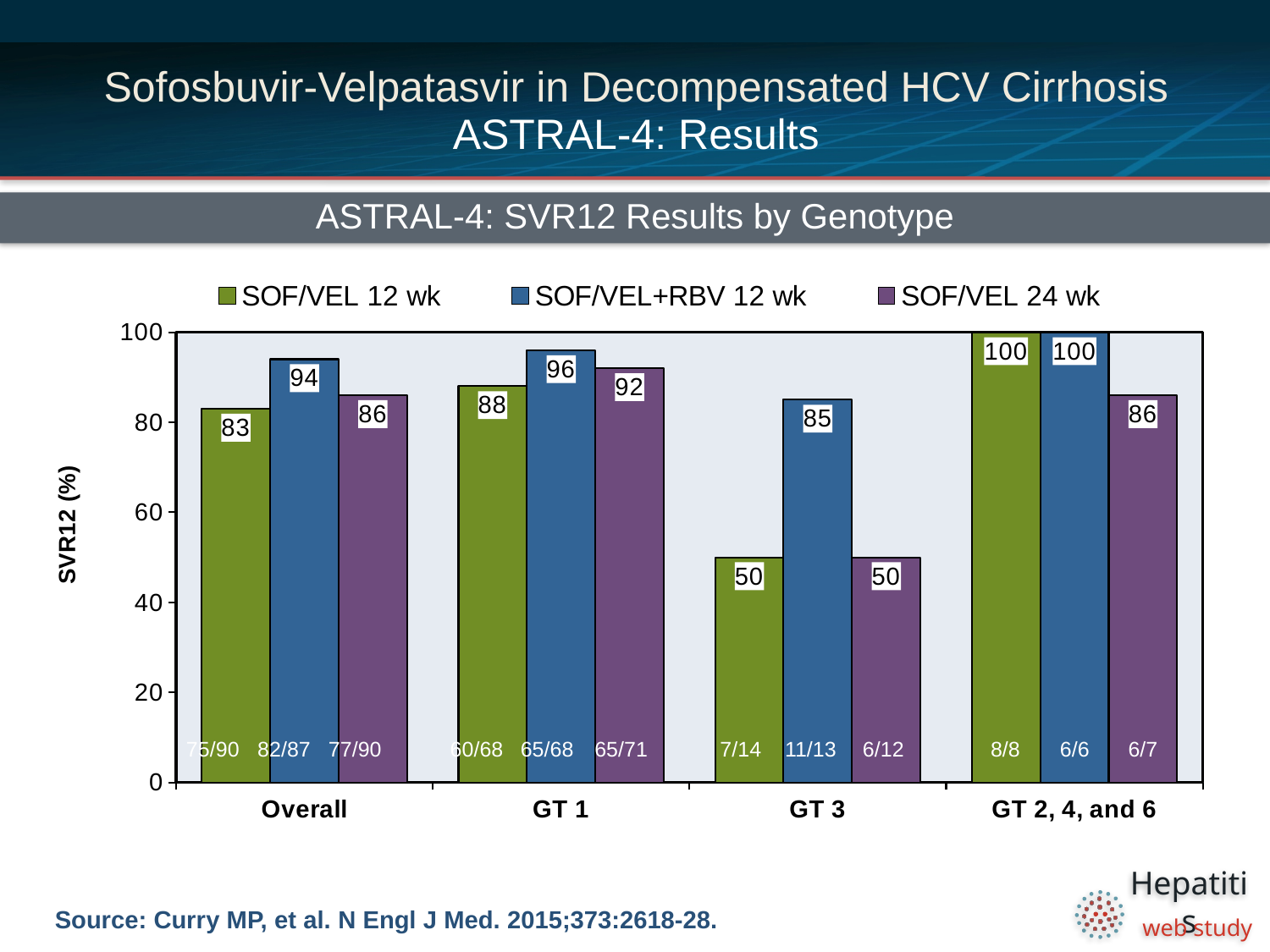
Which genotype group has the lowest SVR12 value for SOF/VEL 12 wk? GT 3 Which is larger in the GT 1 group: the SVR12 value for SOF/VEL 12 wk or for SOF/VEL 24 wk? SOF/VEL 24 wk How many genotype groups are shown on the x axis? 4 What is the SVR12 value for SOF/VEL 12 wk in the Overall group? 83 Is the SVR12 value for SOF/VEL 24 wk in the GT 3 group greater or less than 60? less What is the label of the y axis? SVR12 (%) What is the SVR12 value for SOF/VEL 24 wk in the GT 1 group? 92 Which treatment arm has the highest SVR12 value in the Overall group? SOF/VEL+RBV 12 wk How many series does the legend list? 3 What is the difference between the SOF/VEL+RBV 12 wk and SOF/VEL 12 wk SVR12 values in the GT 3 group? 35 What is the SVR12 value for SOF/VEL+RBV 12 wk in the GT 3 group? 85 What kind of chart is shown on the slide? bar chart